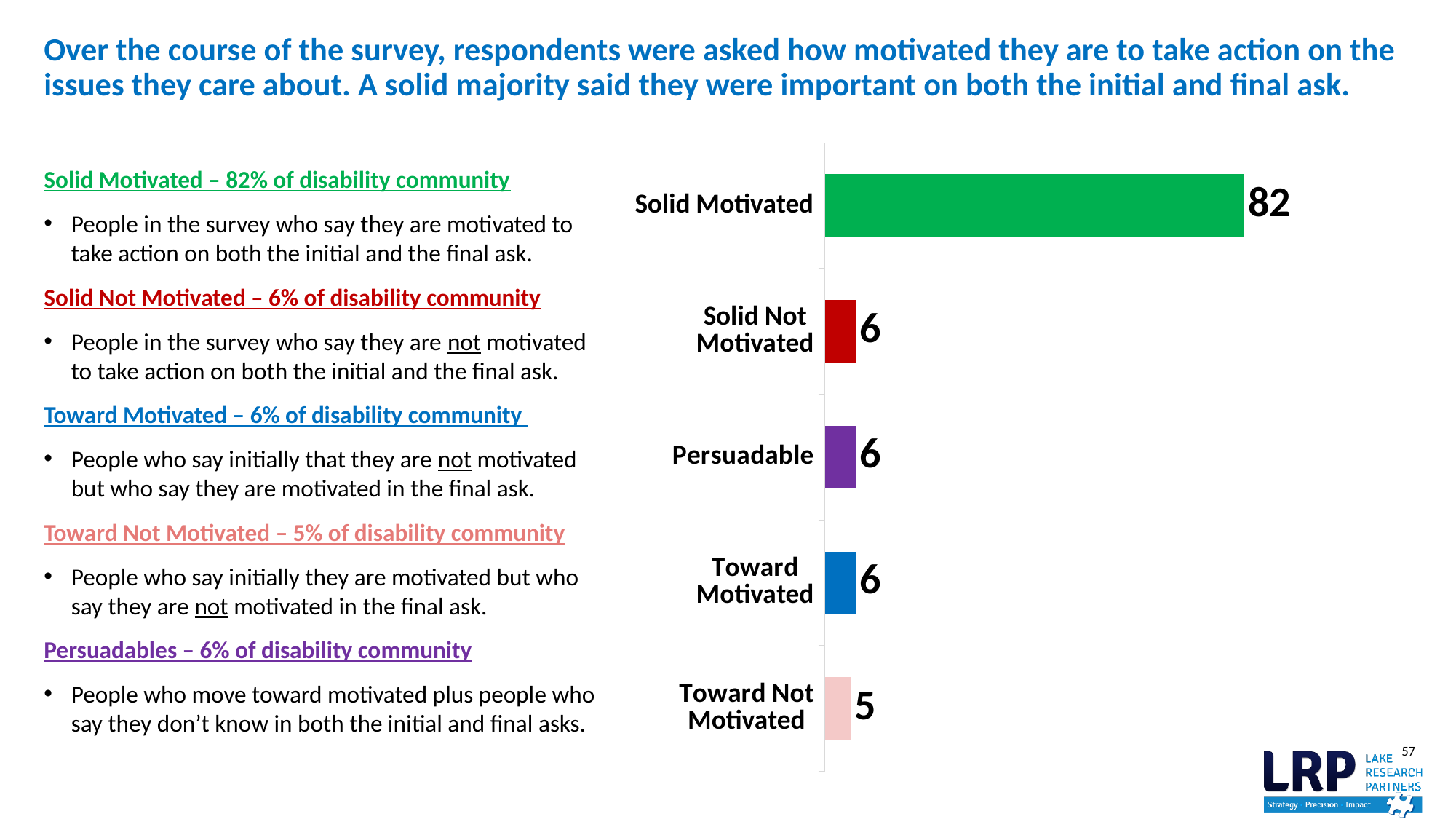
What is the value for Toward Not Motivated? 5 Which category has the lowest value? Toward Not Motivated What is the difference between the values for Toward Motivated and Toward Not Motivated? 1 What is the difference between the values for Solid Motivated and Solid Not Motivated? 76 What colour is the bar for Solid Not Motivated? Red What is the value for Persuadable? 6 Which is larger, the value for Solid Motivated or the value for Persuadable? Solid Motivated What is the value for Solid Motivated? 82 What colour is the bar for Solid Motivated? Green Which category has the highest value? Solid Motivated How many categories are shown in the chart? 5 What kind of chart is shown on the slide? Bar chart